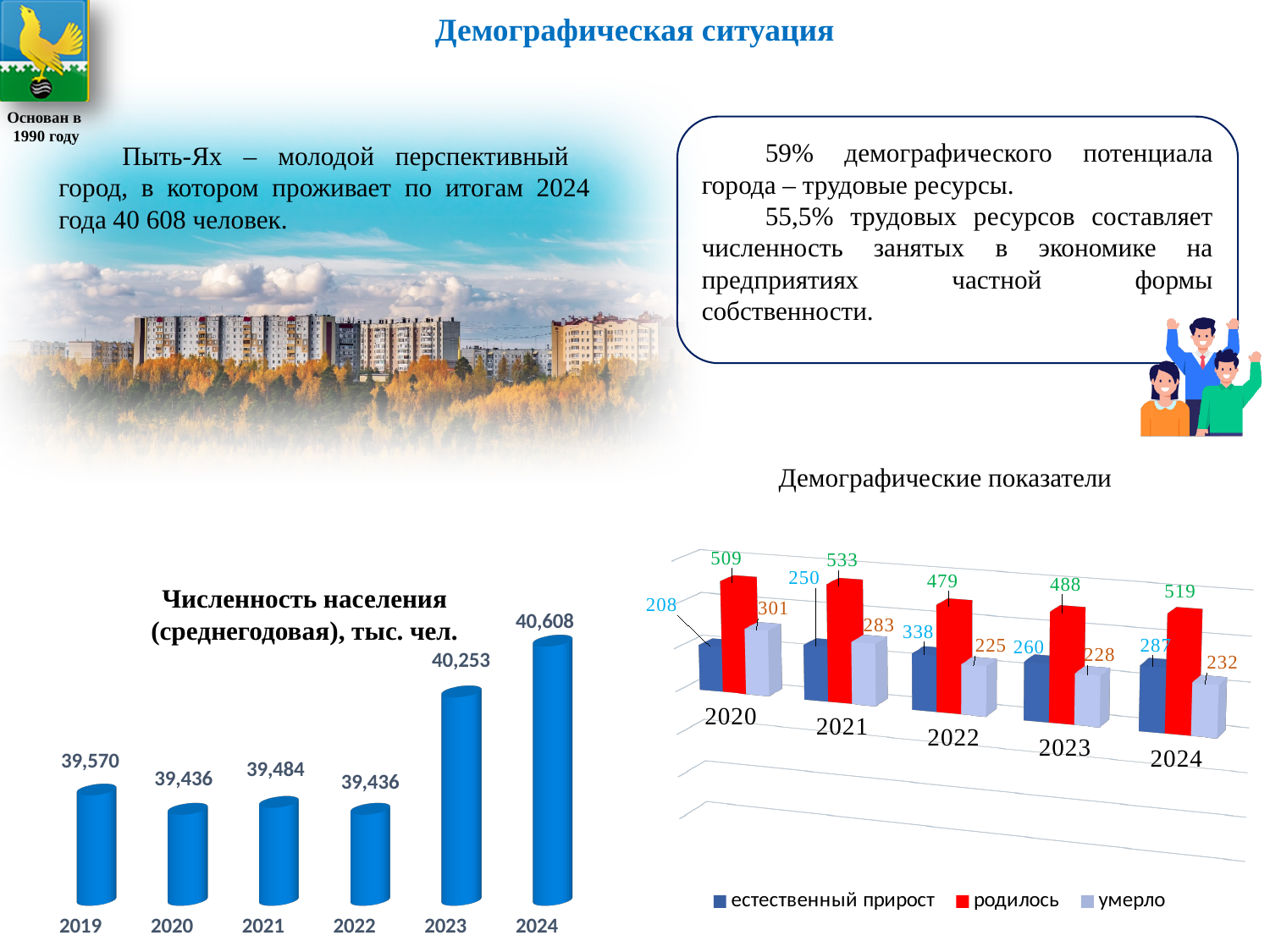
In the chart 'Численность населения (среднегодовая), тыс. чел.', how many years are shown? 6 In the chart 'Численность населения (среднегодовая), тыс. чел.', what is the difference between the values for 2024 and 2023? 355 In the chart 'Численность населения (среднегодовая), тыс. чел.', which year has the highest value? 2024 In the chart 'Демографические показатели', how many series does the legend list? 3 In the chart 'Численность населения (среднегодовая), тыс. чел.', what is the value for 2024? 40,608 In the chart 'Демографические показатели', which is larger: 'родилось' in 2020 or 'родилось' in 2022? 2020 In the chart 'Демографические показатели', what is the value of 'родилось' for 2021? 533 In the chart 'Численность населения (среднегодовая), тыс. чел.', what is the value for 2019? 39,570 In the chart 'Демографические показатели', what is the value of 'умерло' for 2020? 301 In the chart 'Демографические показатели', which year has the lowest value of 'умерло'? 2022 What kind of chart is 'Численность населения (среднегодовая), тыс. чел.'? bar chart